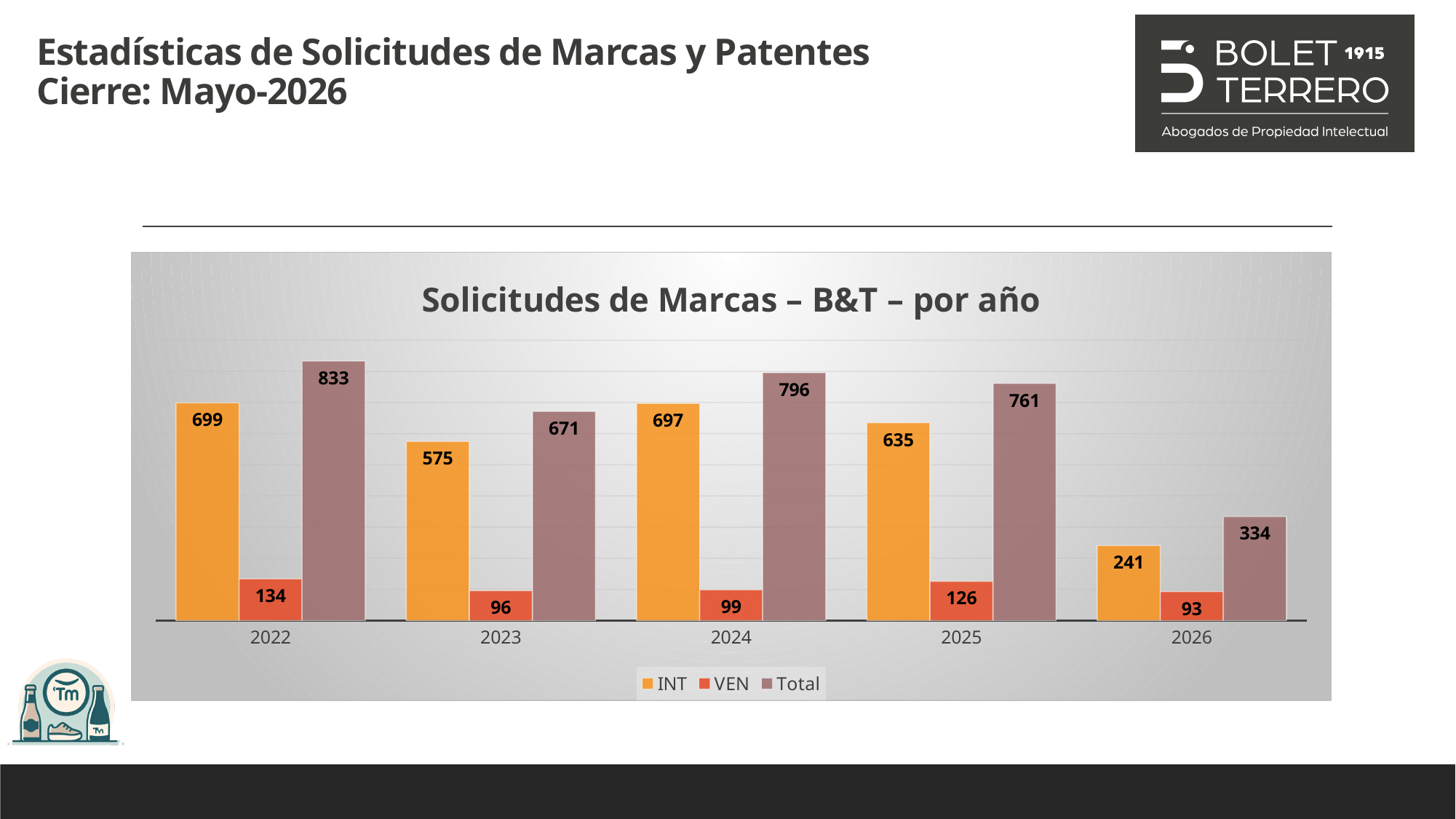
How many series does the legend list? 3 Which year has the highest Total value? 2022 Does the Total value rise or fall from 2025 to 2026? Fall What is the Total value for 2026? 334 What kind of chart is shown on the slide? Bar chart Which year has the lowest VEN value? 2026 Which is larger, the INT value for 2023 or the INT value for 2025? 2025 What is the title of the chart? Solicitudes de Marcas – B&T – por año What is the VEN value for 2022? 134 What is the difference between the Total values for 2022 and 2023? 162 What is the INT value for 2024? 697 How many years are shown on the x axis? 5